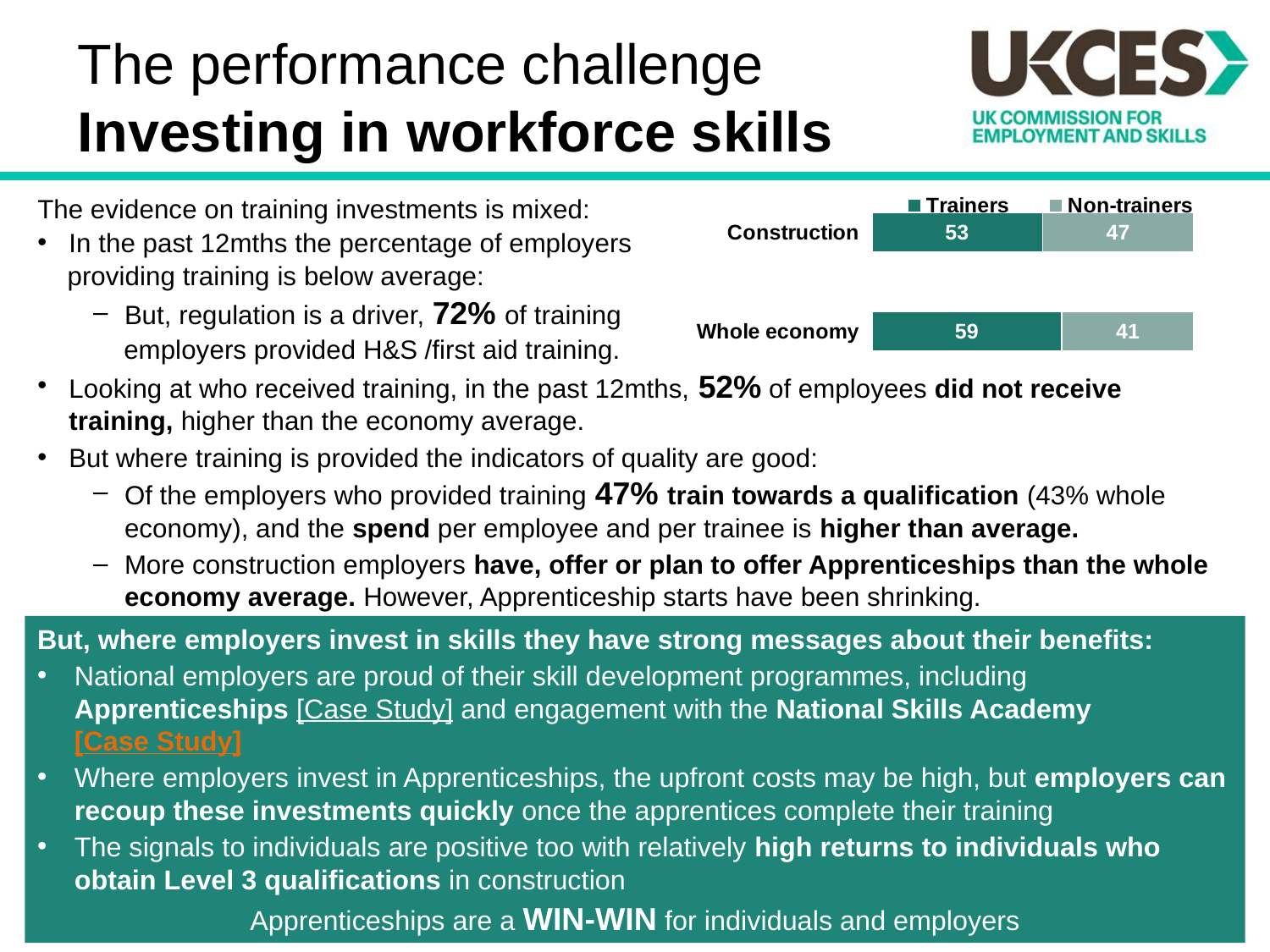
What is the value for Trainers in the Whole economy category? 59 How many categories are shown in the chart? 2 Which category has the lower Non-trainers value? Whole economy What kind of chart is shown on the slide? Stacked bar chart How many series does the legend list? 2 What is the value for Non-trainers in the Construction category? 47 What is the value for Non-trainers in the Whole economy category? 41 What is the difference between the Trainers values for Whole economy and Construction? 6 What are the two series names listed in the chart legend? Trainers and Non-trainers What is the total of the stacked bar for Construction? 100 Which category has the higher Trainers value, Construction or Whole economy? Whole economy What is the value for Trainers in the Construction category? 53